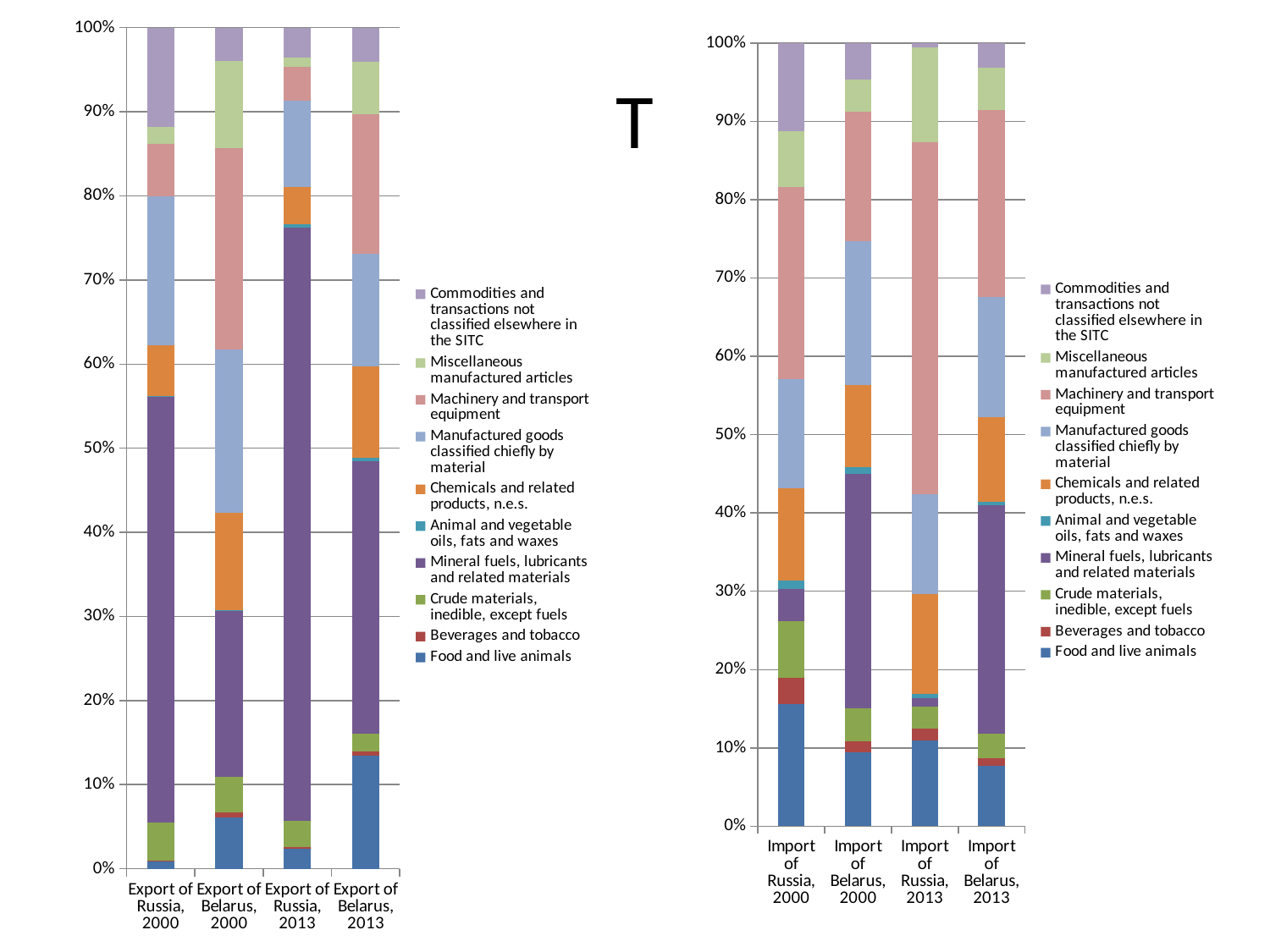
In the chart on the left side of the slide, which category has the largest Mineral fuels, lubricants and related materials segment? Export of Russia, 2013 In the chart on the left side of the slide, is the Food and live animals share for Export of Belarus, 2013 greater or less than 10%? greater In the chart on the right side of the slide, which has a larger Mineral fuels, lubricants and related materials segment: Import of Russia, 2000 or Import of Belarus, 2000? Import of Belarus, 2000 In the chart on the right side of the slide, is the Food and live animals share for Import of Russia, 2000 greater or less than 10%? greater What is the highest value shown on the y axis of the chart on the left side of the slide? 100% In the chart on the left side of the slide, which has a larger Commodities and transactions not classified elsewhere in the SITC segment: Export of Russia, 2000 or Export of Belarus, 2000? Export of Russia, 2000 In the chart on the right side of the slide, which series is shown at the bottom of each stacked bar? Food and live animals In the chart on the right side of the slide, which category has the largest Machinery and transport equipment segment? Import of Russia, 2013 How many series does the legend of the chart on the left side of the slide list? 10 What kind of chart is the chart on the left side of the slide? Stacked bar chart In the chart on the left side of the slide, is the Food and live animals share for Export of Russia, 2000 greater or less than 10%? less How many bars (categories) does the chart on the right side of the slide show? 4